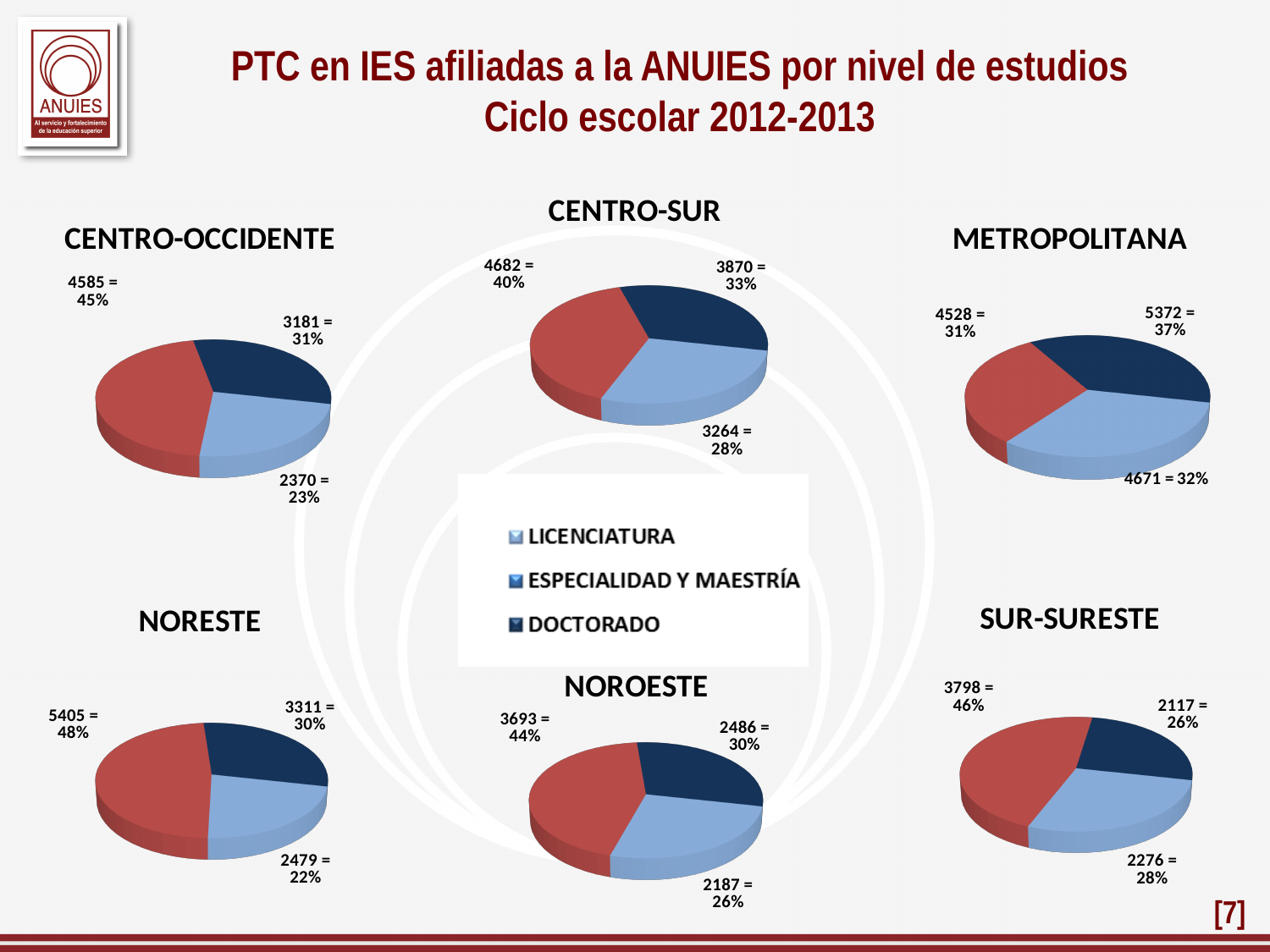
How many pie charts are shown on the slide? 6 In the SUR-SURESTE chart, what value corresponds to the 28% slice? 2276 In the METROPOLITANA chart, which slice is the largest? 5372 = 37% In the CENTRO-SUR chart, what is the total of the three slice values? 11816 In the METROPOLITANA chart, which is larger, the slice labelled 4528 or the slice labelled 4671? 4671 What are the three entries listed in the legend? LICENCIATURA, ESPECIALIDAD Y MAESTRÍA, DOCTORADO In the NORESTE chart, what value is labelled as 48%? 5405 In the SUR-SURESTE chart, which slice is the smallest? 2117 = 26% In the CENTRO-OCCIDENTE chart, what is the difference between the 4585 slice and the 2370 slice? 2215 How many entries does the legend in the centre of the slide list? 3 In the NOROESTE chart, what share of the pie does the 3693 slice represent? 44% What kind of chart is the CENTRO-SUR chart? pie chart